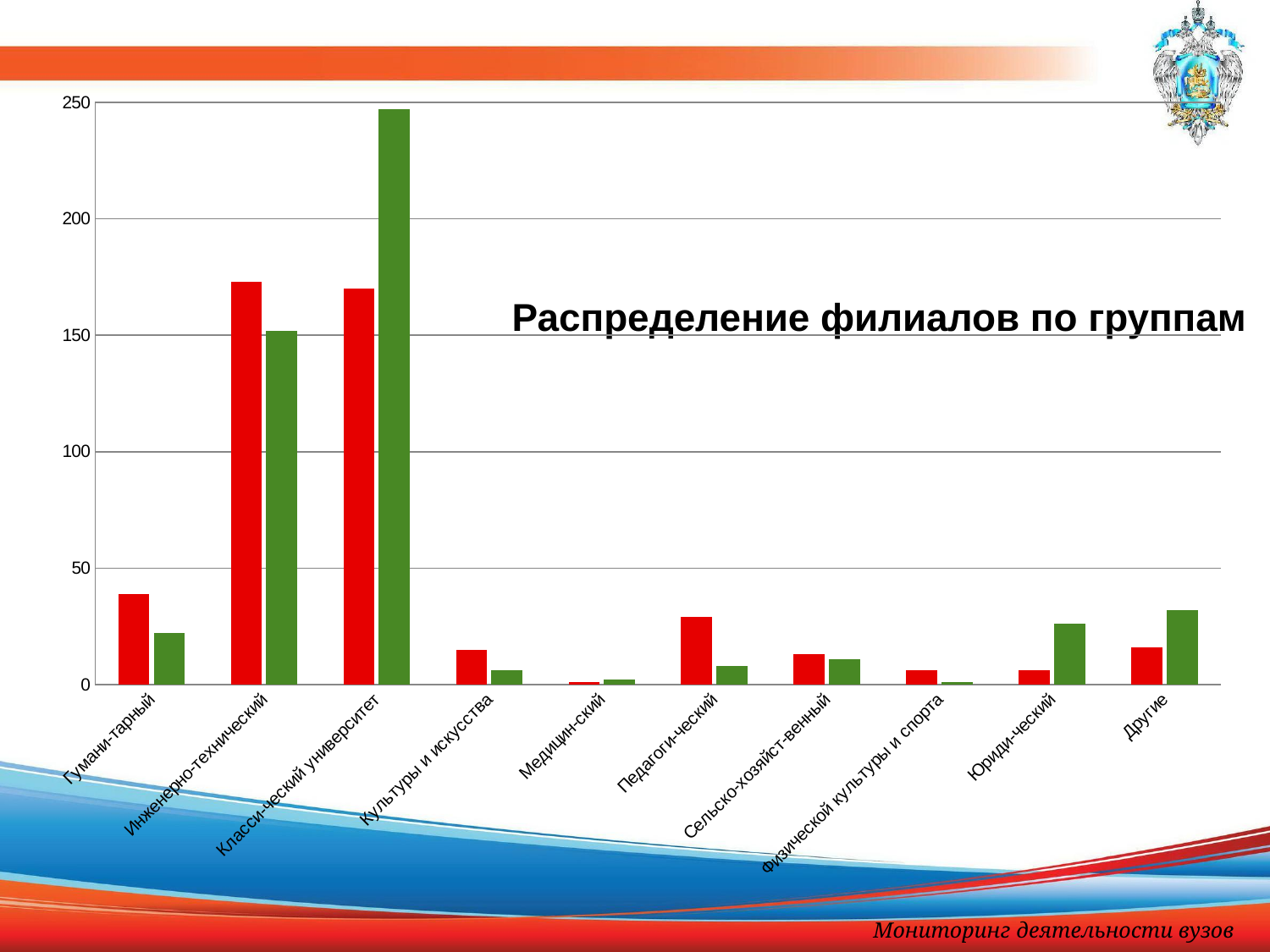
Which category has the tallest bar in the chart? Классический университет How many series (bar colours) are plotted for each category? 2 Is the red bar for Гуманитарный greater or less than 50? less Which category has the lowest red bar? Медицинский For Классический университет, which bar is taller, the red or the green one? green What is the title of the chart? Распределение филиалов по группам What kind of chart is shown on the slide? bar chart Is the green bar for Классический университет greater or less than 200? greater For Гуманитарный, which bar is taller, the red or the green one? red How many categories are shown along the x axis of the chart? 10 Is the red bar for Инженерно-технический greater or less than 150? greater For Юридический, which bar is taller, the red or the green one? green